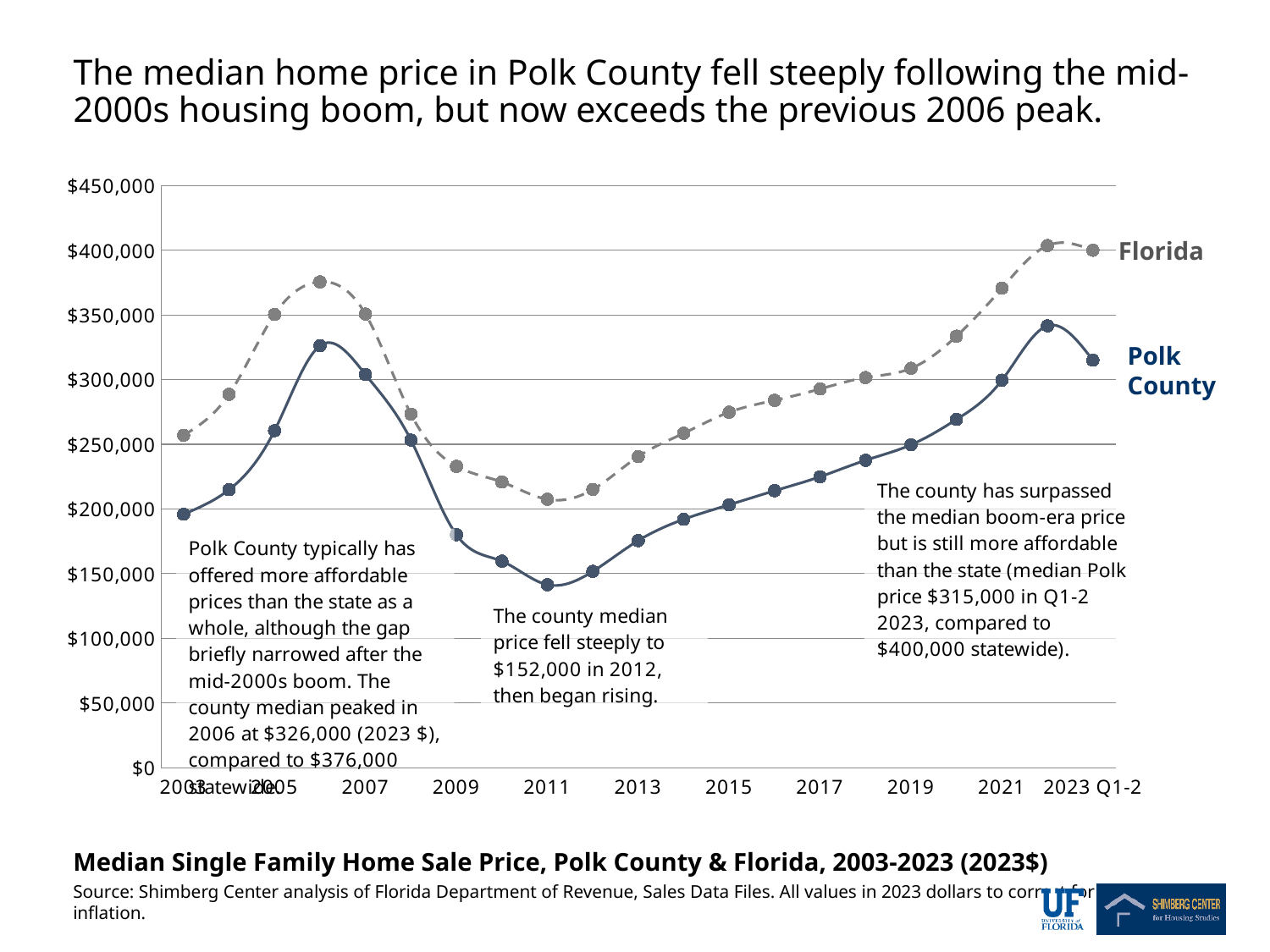
What is the difference between the statewide and Polk County medians in Q1-2 2023? $85,000 Which series has the higher value in 2023 Q1-2, Florida or Polk County? Florida What is the statewide median home price in Q1-2 2023, as stated on the slide? $400,000 According to the slide, what was the statewide (Florida) median home price in 2006? $376,000 Is the Polk County value for 2019 greater or less than $300,000? less How many series are plotted on the chart? 2 Does the Polk County line rise or fall between 2012 and 2021? rise According to the slide, what was the Polk County median home price at its 2006 peak? $326,000 How much higher was the Florida median than the Polk County median in 2006? $50,000 What is the median Polk County home price in Q1-2 2023, as stated on the slide? $315,000 What kind of chart is shown on the slide? line chart Is the Florida value for 2021 greater or less than $350,000? greater